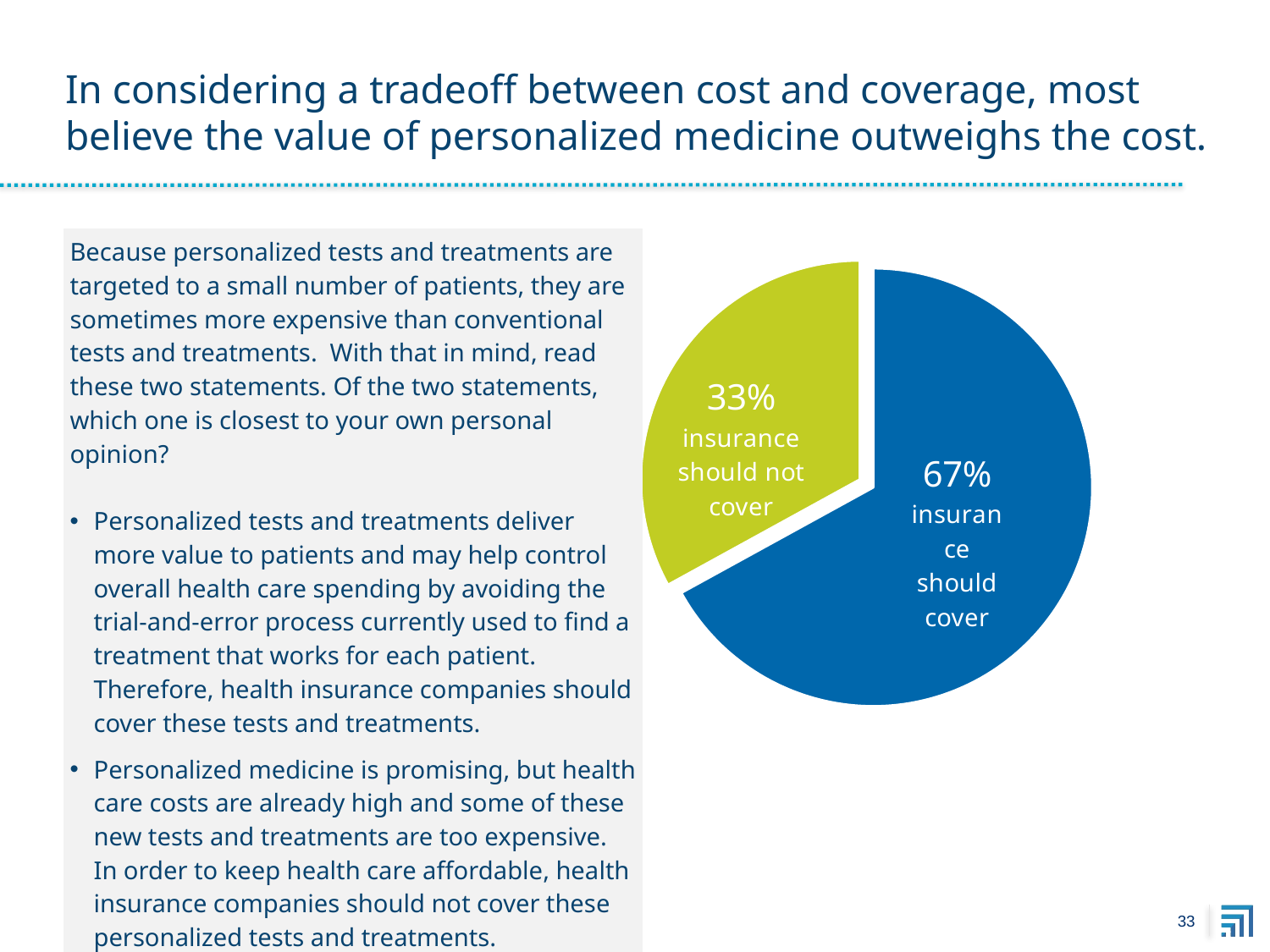
What share of the pie does the 'insurance should not cover' slice represent? 33% Which slice of the pie is the smallest? insurance should not cover Which slice of the pie is the largest? insurance should cover What is the difference in percentage points between the 'insurance should cover' and 'insurance should not cover' slices? 34 What kind of chart is shown on the slide? pie chart Which is larger: the share saying insurance should cover, or the share saying insurance should not cover? insurance should cover How many slices does the pie chart have? 2 What percentage of respondents say insurance should not cover personalized tests and treatments? 33% What colour is the 'insurance should cover' slice? blue What colour is the 'insurance should not cover' slice? green What percentage of respondents say insurance should cover personalized tests and treatments? 67%